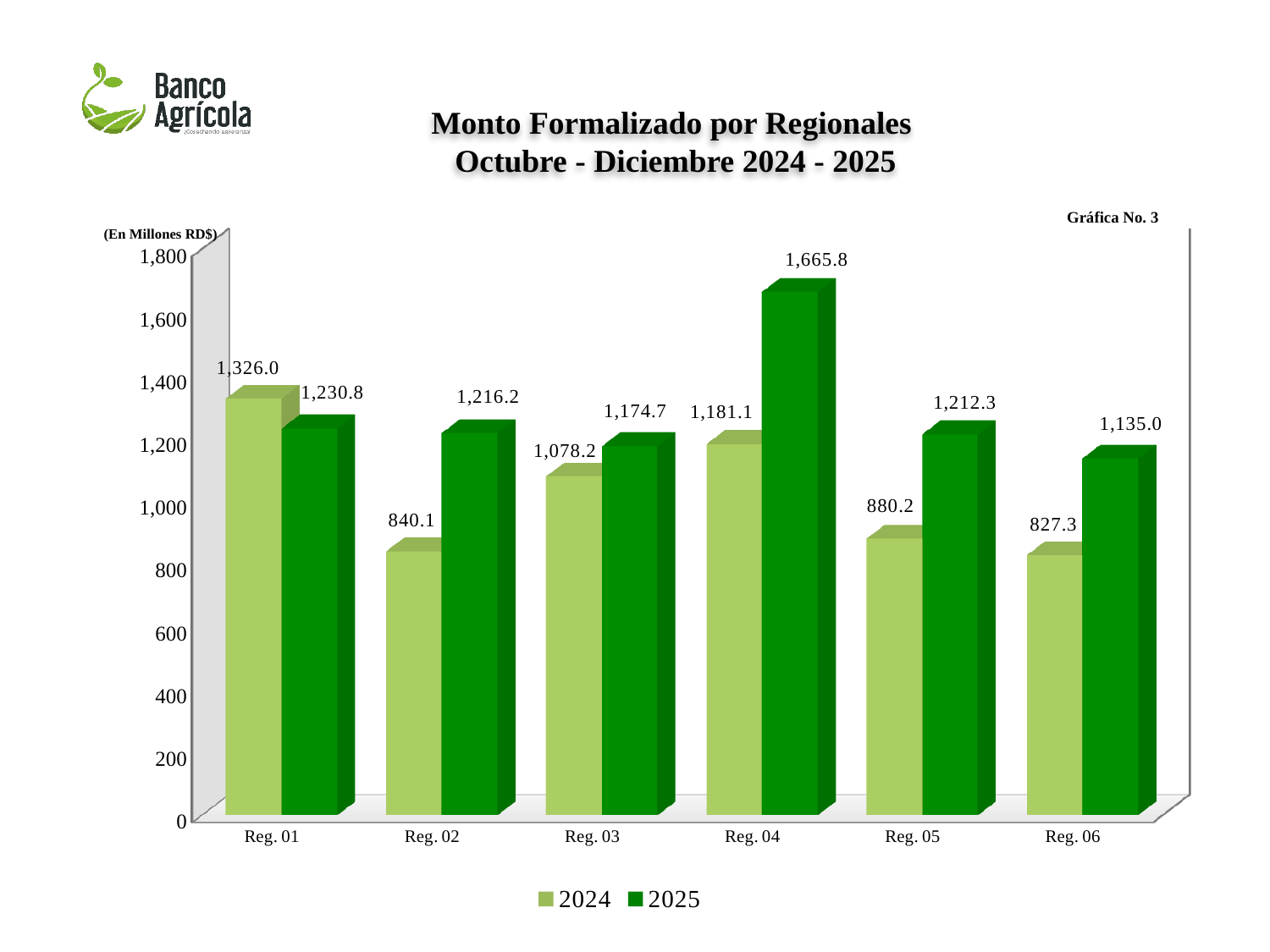
Which region has the highest value for 2025? Reg. 04 What is the value for 2024 in Reg. 02? 840.1 What is the value for 2025 in Reg. 04? 1,665.8 How many regions are shown on the x axis? 6 What kind of chart is shown on the slide? Bar chart How many series does the legend list? 2 What is the difference between the 2025 and 2024 values in Reg. 04? 484.7 Which region has the lowest value for 2024? Reg. 06 In Reg. 01, which series has the larger value, 2024 or 2025? 2024 Which region has the highest value for 2024? Reg. 01 What is the value for 2025 in Reg. 06? 1,135.0 What is the difference between the 2025 and 2024 values in Reg. 02? 376.1